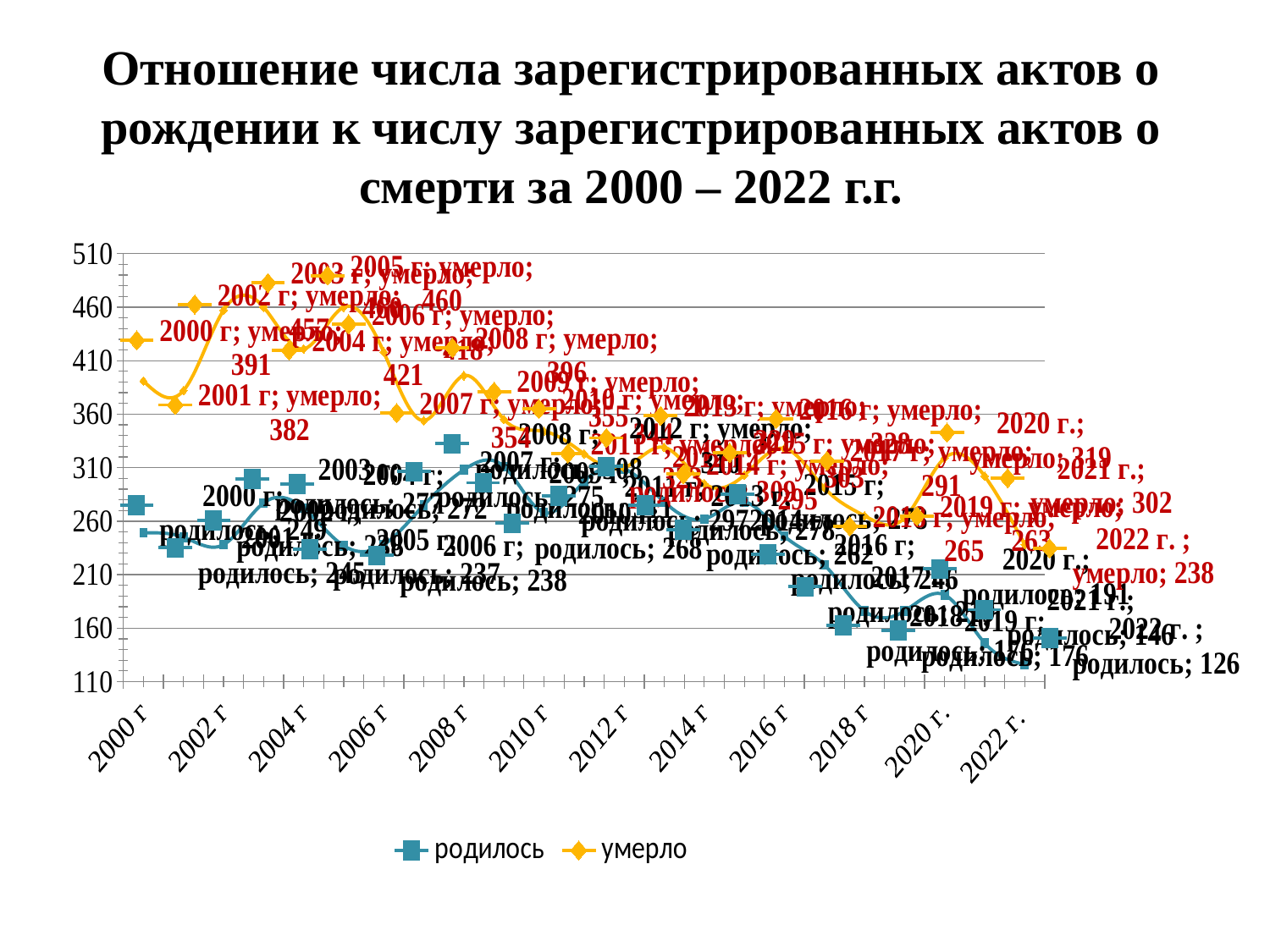
What is the value for умерло in 2022 г.? 238 What is the value for родилось in 2000 г? 249 What is the difference between умерло and родилось in 2000 г? 142 What is the value for умерло in 2000 г? 391 How many series does the legend list? 2 In 2000 г, which is larger: родилось or умерло? умерло What kind of chart is shown on the slide? line chart What is the value for умерло in 2001 г? 382 What are the two series named in the legend? родилось and умерло What is the value for умерло in 2004 г? 421 What is the value for родилось in 2006 г? 238